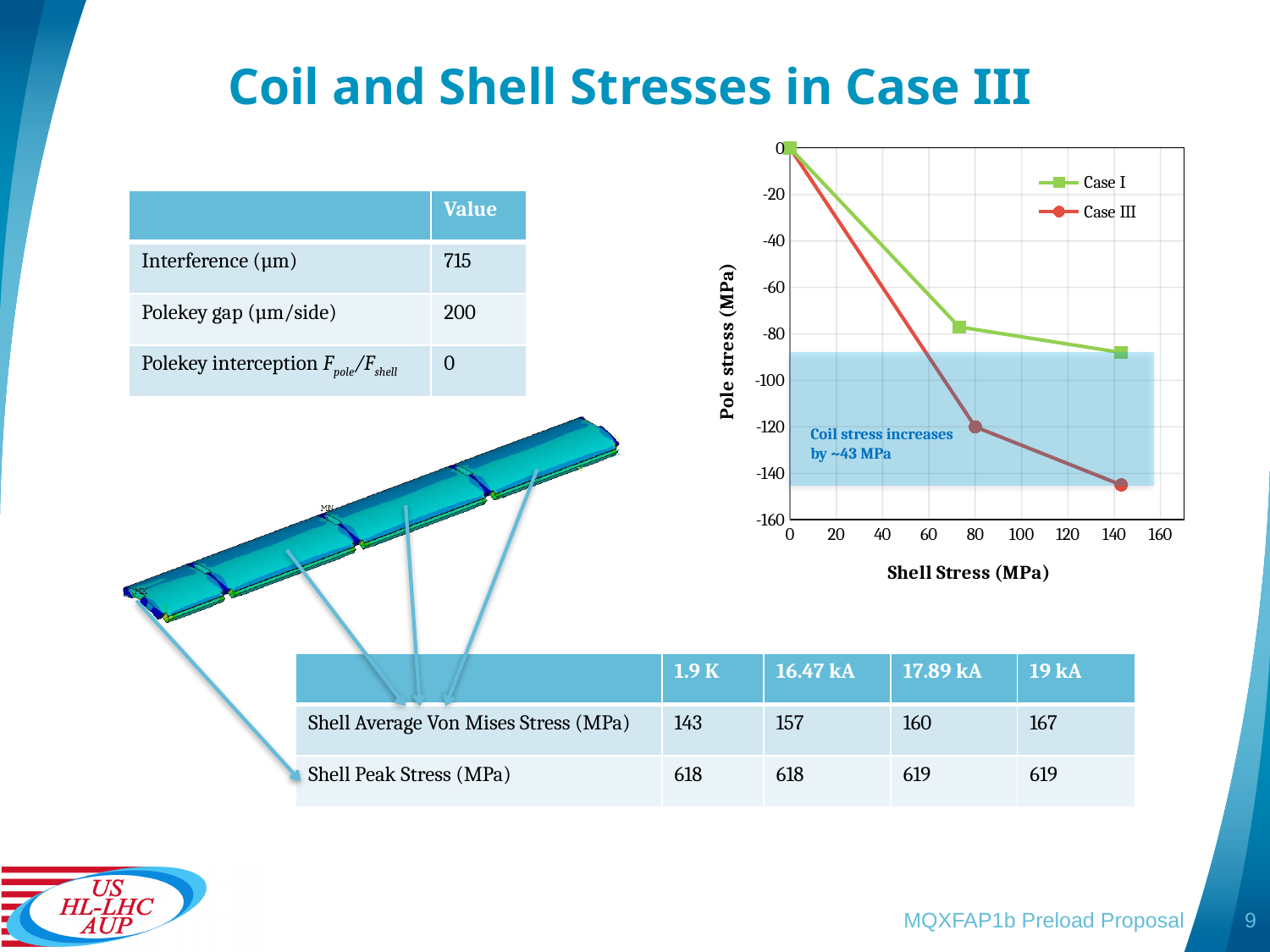
Is the pole stress of the middle Case I point greater or less than -60 MPa? less As shell stress increases along the x axis, does the pole stress for Case III rise or fall? fall Is the pole stress of the last Case III point greater or less than -120 MPa? less What kind of chart is shown on the slide? line chart At the highest shell stress plotted, which series has the more negative pole stress, Case I or Case III? Case III How many data points are plotted for the Case III series? 3 What is the maximum value shown on the chart's x axis? 160 Which series has the lowest (most negative) pole stress value anywhere on the chart? Case III Is the pole stress of the last Case I point greater or less than -100 MPa? greater What are the two series named in the chart legend? Case I and Case III How many series does the chart legend list? 2 What is the title of the chart's x axis? Shell Stress (MPa)